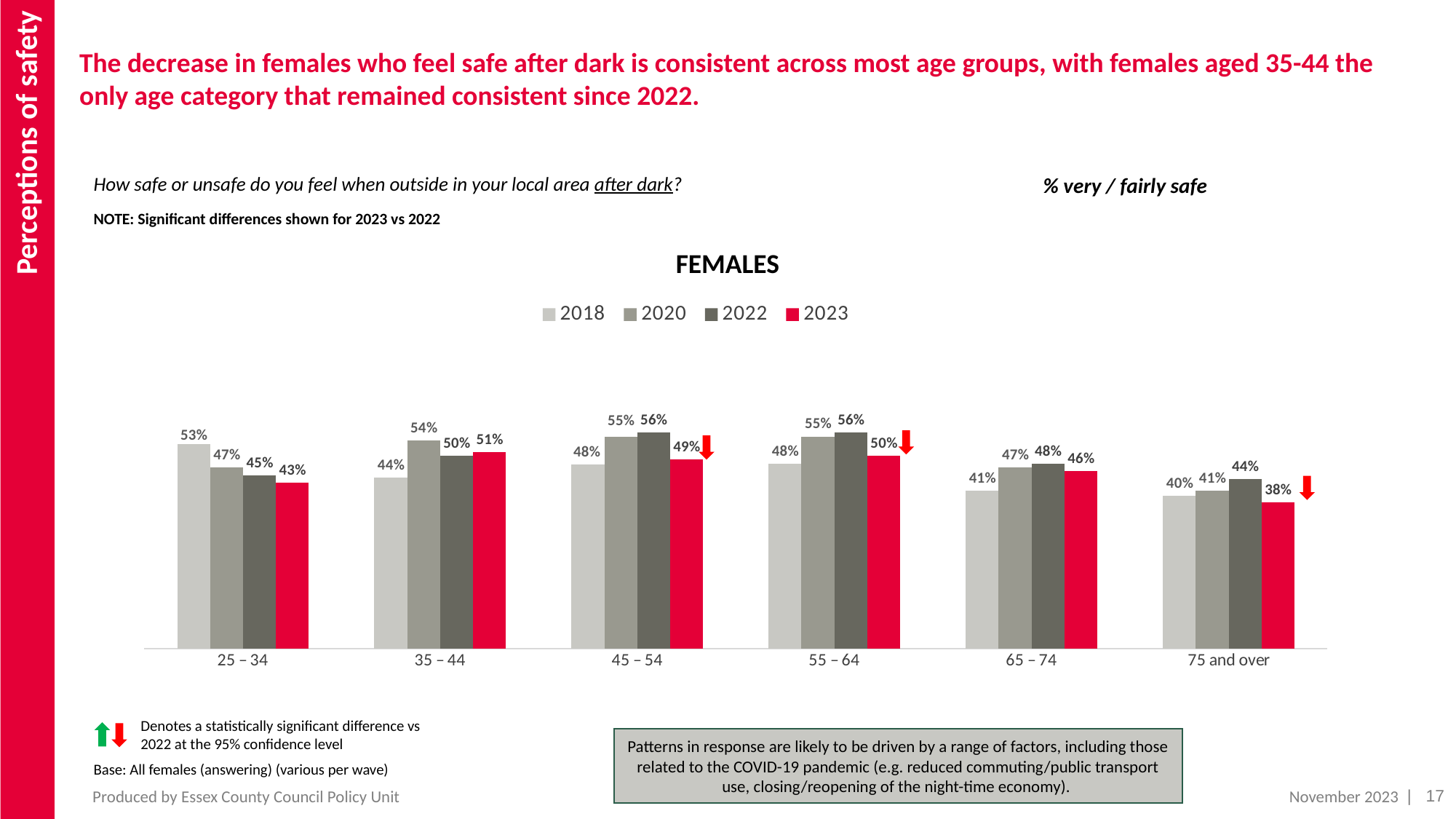
What kind of chart is shown on the slide? Bar chart What is the difference between the 2018 and 2020 values for females aged 35 – 44? 10% What is the difference between the 2022 and 2023 values for females aged 45 – 54? 7% Which age group has the highest 2018 value? 25 – 34 What is the 2023 value for females aged 25 – 34? 43% Which age group has the lowest 2023 value? 75 and over Which is larger for females aged 55 – 64: the 2020 value or the 2023 value? 2020 How many series does the legend list? 4 What is the 2020 value for females aged 65 – 74? 47% How many age groups are shown on the x axis? 6 What is the 2022 value for females aged 75 and over? 44% What is the 2018 value for females aged 35 – 44? 44%